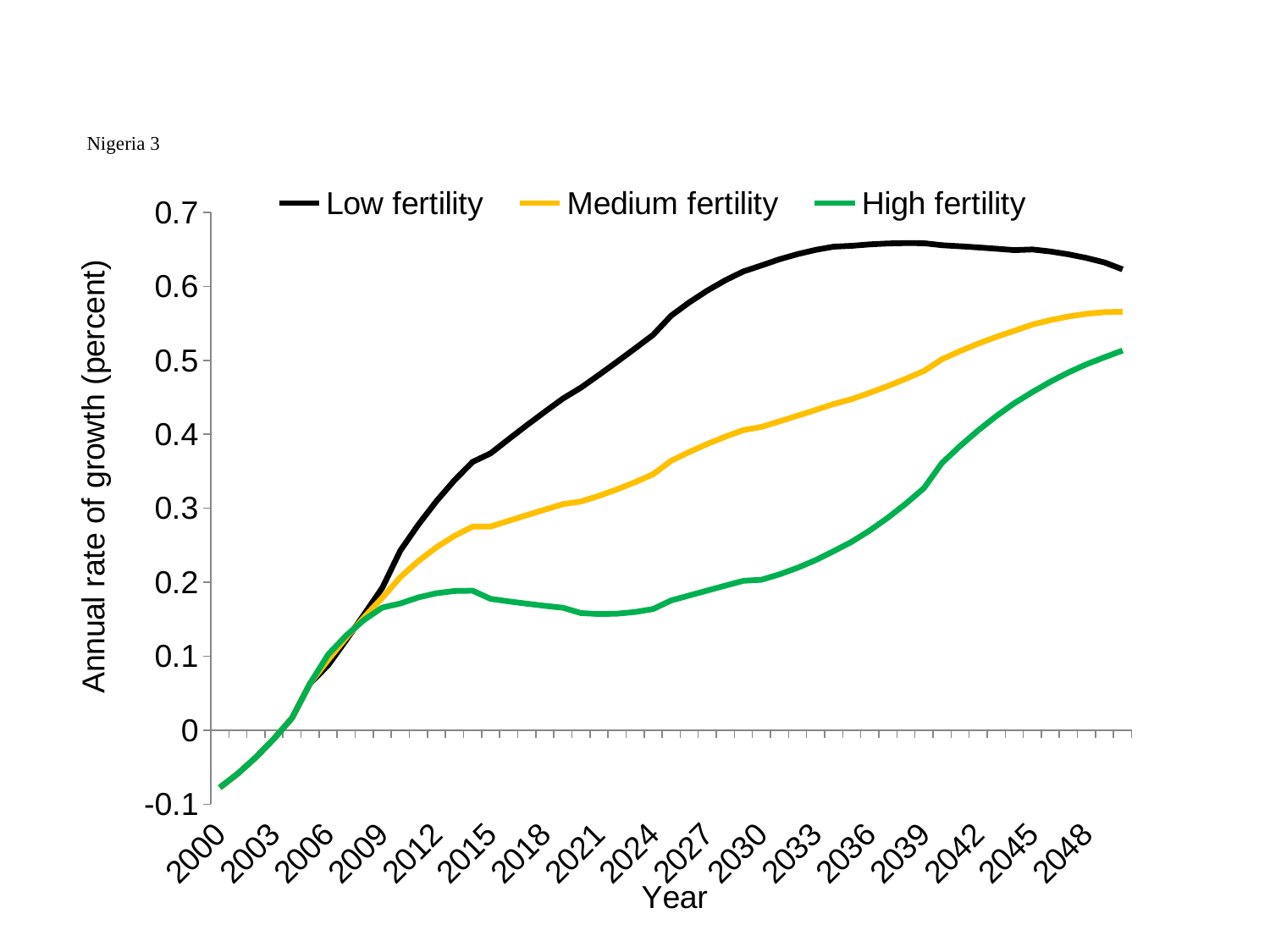
Does the Medium fertility series generally rise or fall from 2000 to 2048? rise Which series has the lowest value in 2024? High fertility Which is larger in 2045: the Medium fertility value or the High fertility value? Medium fertility Is the value for High fertility in 2021 greater or less than 0.2? less How many series does the legend list? 3 What are the three series named in the legend? Low fertility, Medium fertility, High fertility Does the High fertility series rise or fall between 2015 and 2021? fall Which series has the highest value in 2036? Low fertility What kind of chart is shown on the slide? line chart Is the value for Medium fertility in 2030 greater or less than 0.5? less What is the label of the y axis? Annual rate of growth (percent) Is the value for Low fertility in 2036 greater or less than 0.6? greater